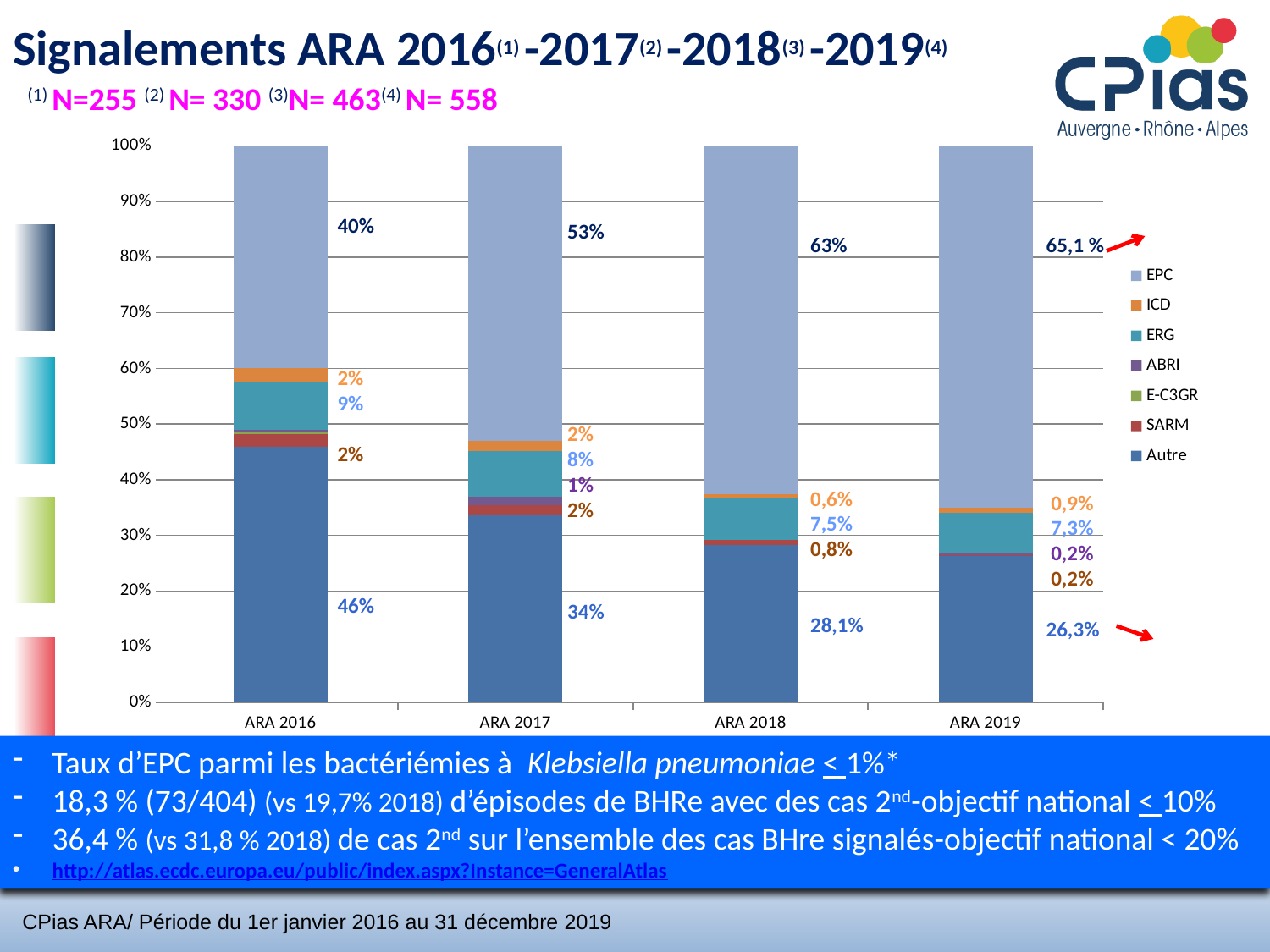
How many categories (years) are shown on the x axis of the chart? 4 Which is larger: the 'Autre' share in ARA 2017 or in ARA 2018? ARA 2017 What is the ERG share for ARA 2018? 7,5% How many series does the chart legend list? 7 Does the EPC share rise or fall from ARA 2016 to ARA 2019? Rise What is the 'Autre' share for ARA 2016? 46% What is the difference in EPC share between ARA 2018 and ARA 2016? 23 percentage points What type of chart is shown on the slide? Stacked bar chart What is the ICD share for ARA 2019? 0,9% What is the EPC share for ARA 2019? 65,1 % In which year is the EPC share the highest? ARA 2019 In which year is the 'Autre' share the lowest? ARA 2019